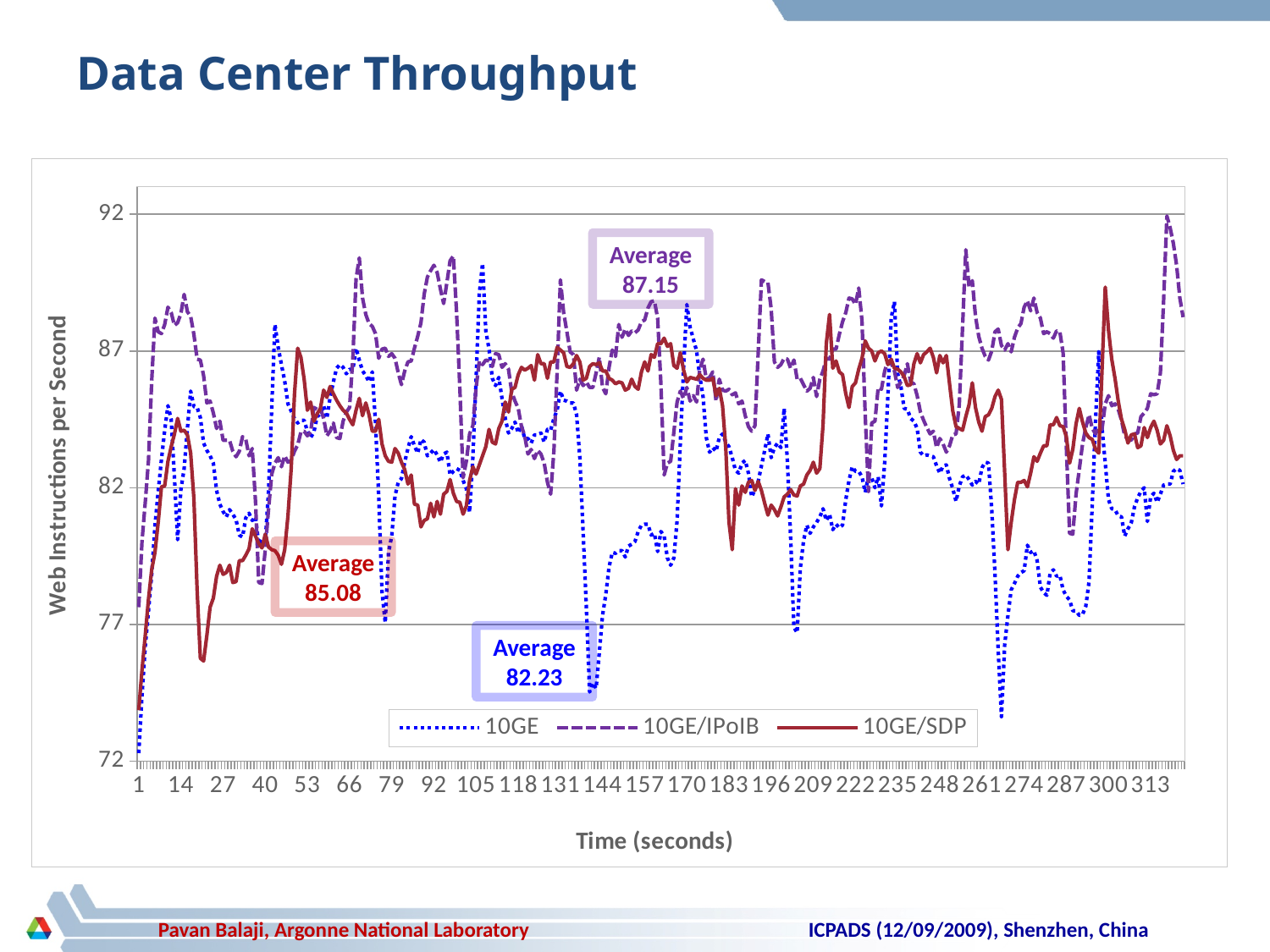
What kind of chart is shown on the slide? Line chart What is the average value annotated for the 10GE series? 82.23 What is the difference between the annotated averages of 10GE/IPoIB and 10GE? 4.92 Which has a larger annotated average, 10GE/SDP or 10GE? 10GE/SDP Is the lowest value of the 10GE series greater or less than 77? less What is the average value annotated for the 10GE/IPoIB series? 87.15 Which series has the lowest annotated average? 10GE What is the label of the y axis? Web Instructions per Second How many series does the legend list? 3 Which series has the highest annotated average? 10GE/IPoIB What are the three series listed in the legend? 10GE, 10GE/IPoIB, 10GE/SDP What is the average value annotated for the 10GE/SDP series? 85.08